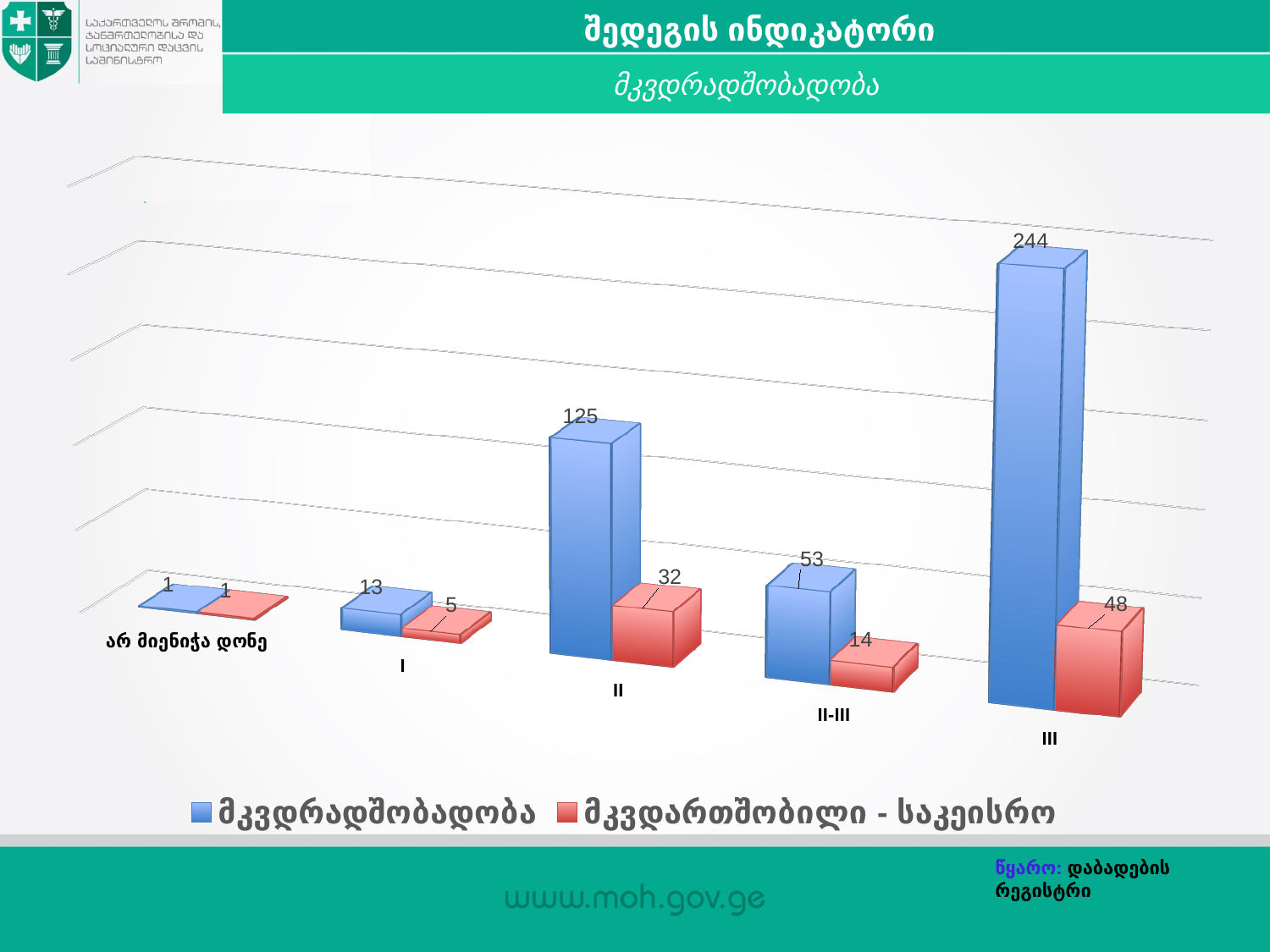
How many categories are shown on the x axis? 5 What is the difference between the მკვდრადშობადობა values for III and II? 119 What is the value of მკვდართშობილი - საკეისრო for category I? 5 Which is larger: მკვდრადშობადობა for II or მკვდრადშობადობა for II-III? II Which colour represents the series მკვდართშობილი - საკეისრო in the legend? red What is the value of მკვდრადშობადობა for category II-III? 53 Which category has the lowest value for მკვდართშობილი - საკეისრო? არ მიენიჭა დონე What is the value of მკვდრადშობადობა for category III? 244 Which category has the highest value for მკვდრადშობადობა? III What is the value of მკვდართშობილი - საკეისრო for category II? 32 How many series does the legend list? 2 What kind of chart is shown on the slide? bar chart